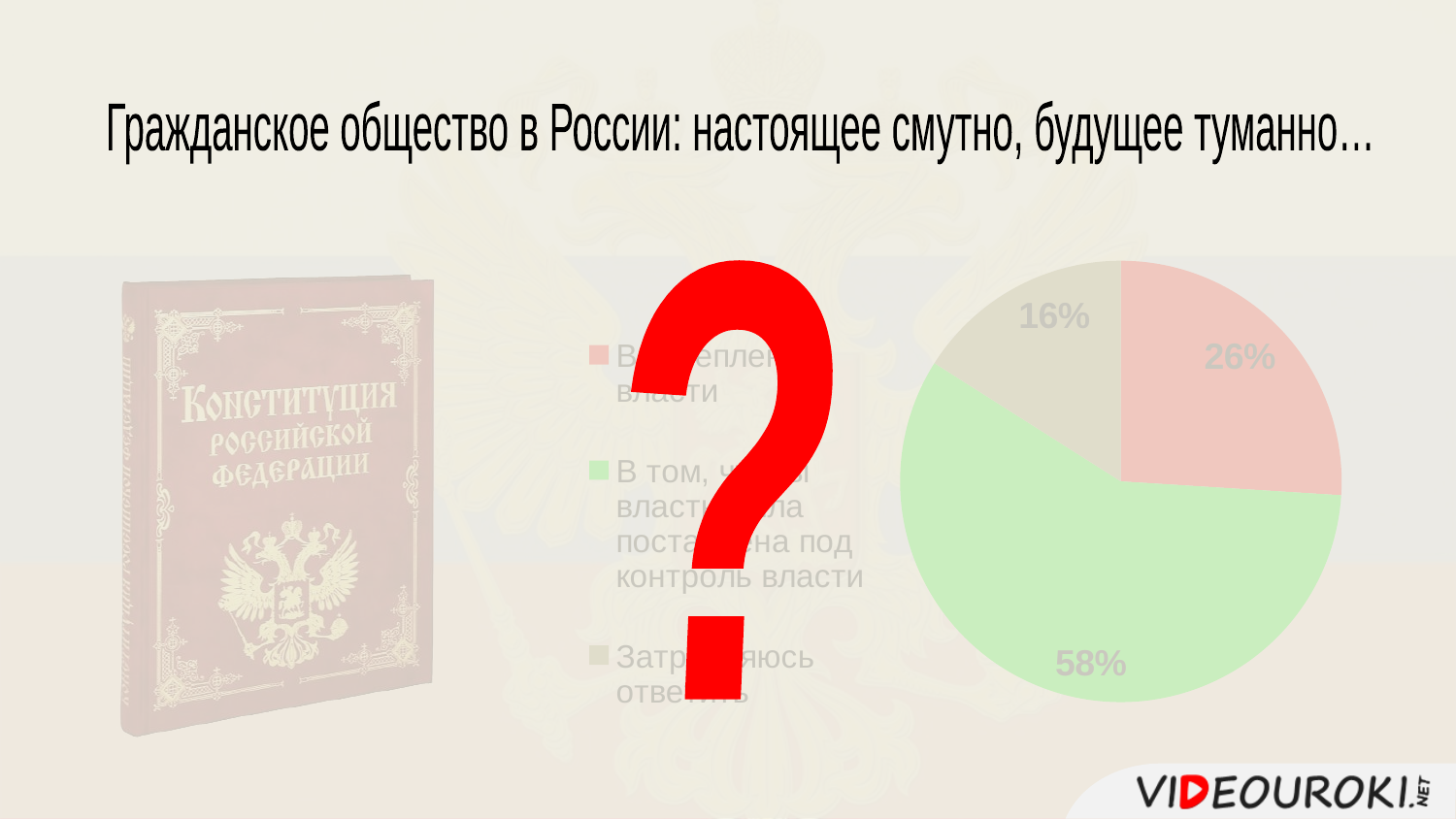
What is the difference in percentage points between the pink slice and the beige slice of the pie chart? 10 What value is shown on the beige slice of the pie chart? 16% What is the value of the largest slice of the pie chart? 58% How many slices does the pie chart have? 3 What is the value of the smallest slice of the pie chart? 16% What colour is the largest slice of the pie chart? green How many entries does the legend of the pie chart list? 3 Which slice of the pie chart is larger, the pink one or the beige one? the pink one What kind of chart is shown on the slide? pie chart What value is shown on the pink slice of the pie chart? 26% What value is shown on the green slice of the pie chart? 58% What is the difference in percentage points between the green slice and the pink slice of the pie chart? 32